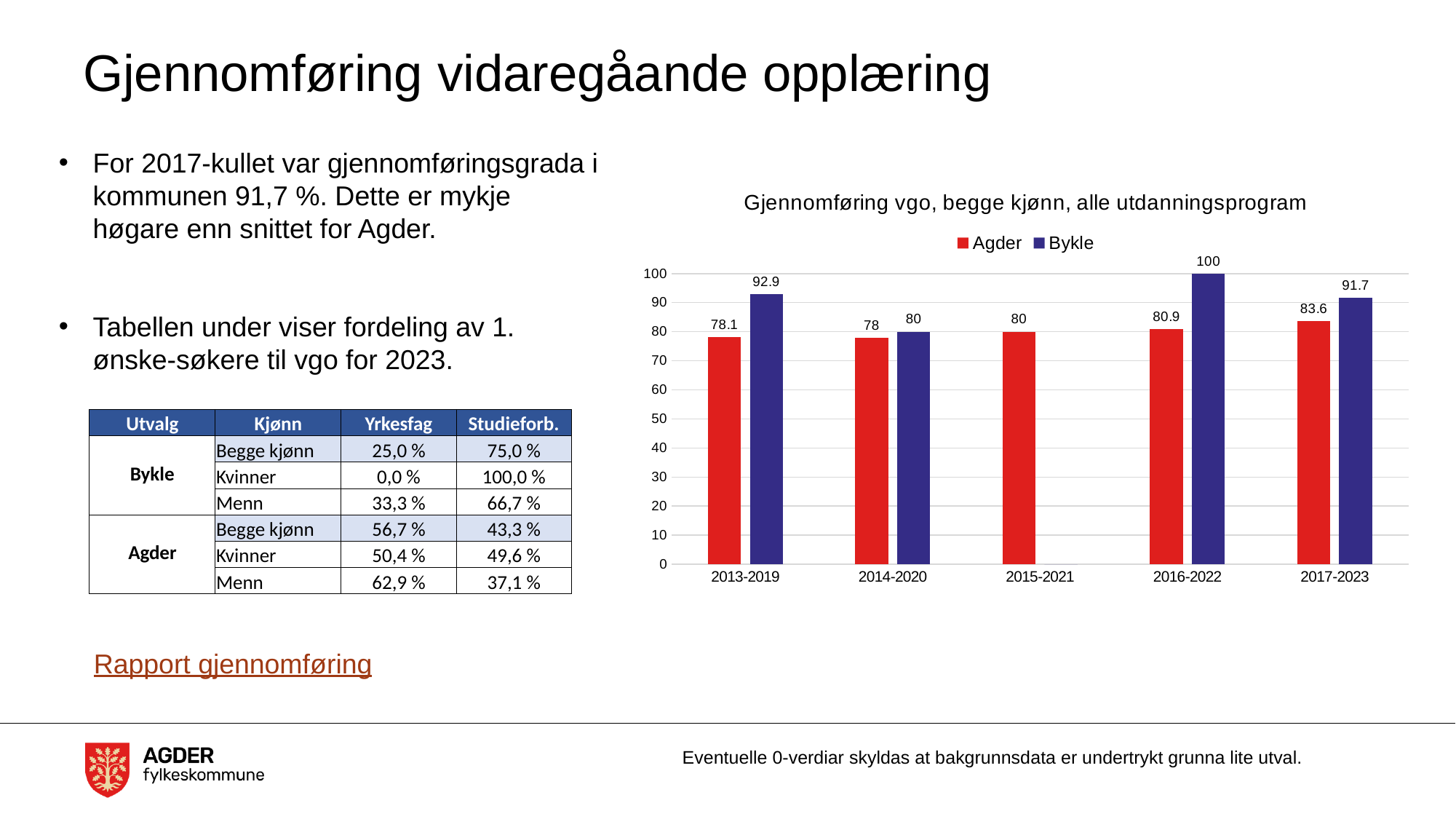
How many series does the chart legend list? 2 What is the value for Agder in 2016-2022? 80.9 In which period is the Bykle value highest? 2016-2022 What is the title of the chart? Gjennomføring vgo, begge kjønn, alle utdanningsprogram Which is larger in 2014-2020, the Agder value or the Bykle value? Bykle In which period is the Agder value lowest? 2014-2020 How many periods are shown on the x axis? 5 What is the value for Agder in 2017-2023? 83.6 What type of chart is shown on the slide? bar chart What is the value for Bykle in 2013-2019? 92.9 What is the difference between the Bykle and Agder values in 2017-2023? 8.1 Does the Agder value rise or fall from 2014-2020 to 2017-2023? rise